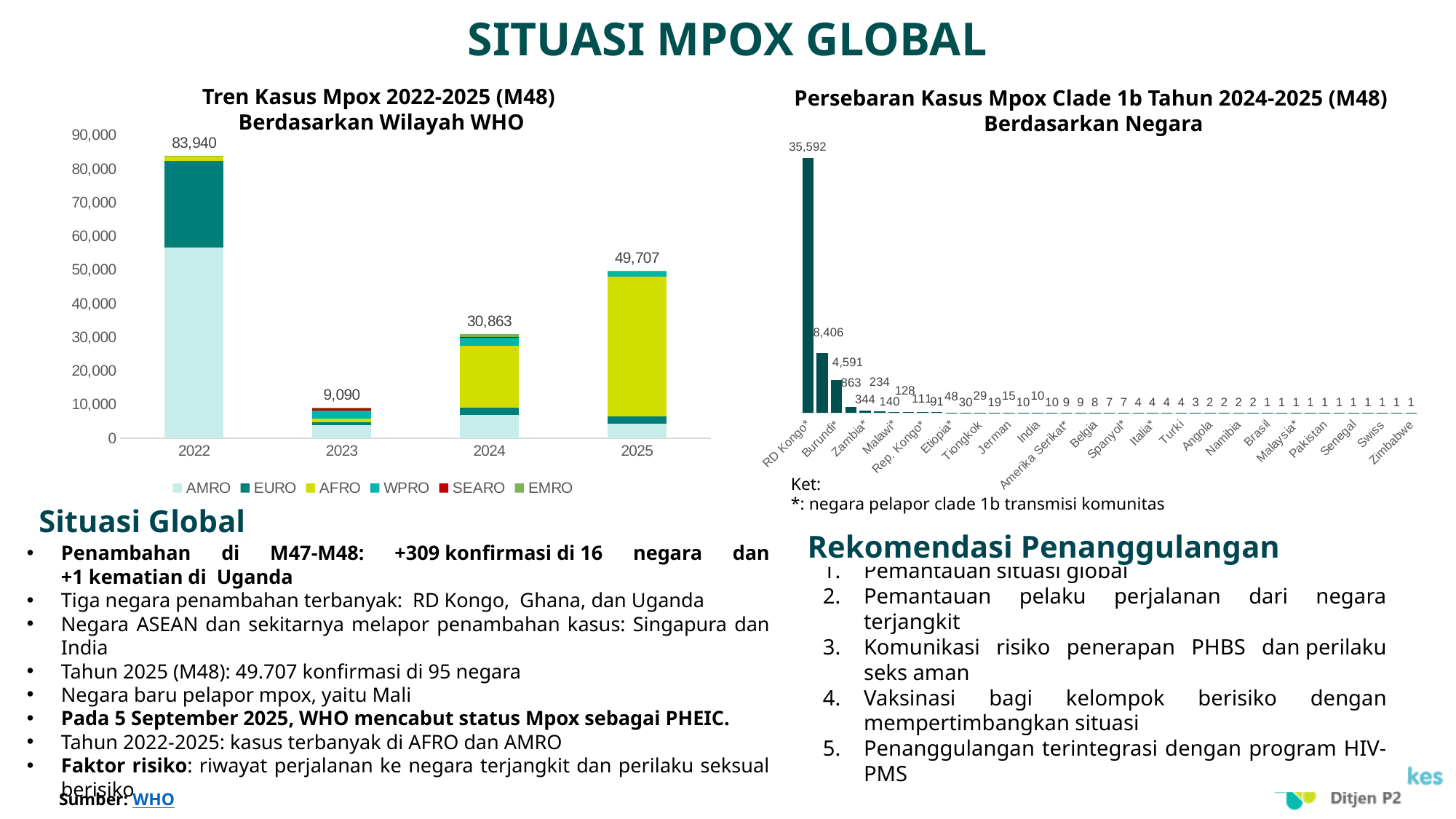
In the chart 'Tren Kasus Mpox 2022-2025 (M48) Berdasarkan Wilayah WHO', which is larger, the total for 2023 or the total for 2024? 2024 In the chart 'Tren Kasus Mpox 2022-2025 (M48) Berdasarkan Wilayah WHO', which year has the lowest total? 2023 In the chart 'Tren Kasus Mpox 2022-2025 (M48) Berdasarkan Wilayah WHO', what is the difference between the 2025 total and the 2024 total? 18,844 How many years are shown on the x axis of the chart 'Tren Kasus Mpox 2022-2025 (M48) Berdasarkan Wilayah WHO'? 4 In the chart 'Tren Kasus Mpox 2022-2025 (M48) Berdasarkan Wilayah WHO', what is the total number of cases for 2025? 49,707 In the chart 'Tren Kasus Mpox 2022-2025 (M48) Berdasarkan Wilayah WHO', which year has the highest total? 2022 Do the totals in the chart 'Tren Kasus Mpox 2022-2025 (M48) Berdasarkan Wilayah WHO' rise or fall from 2023 to 2025? rise In the chart 'Persebaran Kasus Mpox Clade 1b Tahun 2024-2025 (M48) Berdasarkan Negara', what is the value for RD Kongo*? 35,592 What kind of chart is 'Tren Kasus Mpox 2022-2025 (M48) Berdasarkan Wilayah WHO'? stacked bar chart In the chart 'Persebaran Kasus Mpox Clade 1b Tahun 2024-2025 (M48) Berdasarkan Negara', which country has the highest number of cases? RD Kongo* How many series does the legend of the chart 'Tren Kasus Mpox 2022-2025 (M48) Berdasarkan Wilayah WHO' list? 6 In the chart 'Tren Kasus Mpox 2022-2025 (M48) Berdasarkan Wilayah WHO', what is the total number of cases for 2022? 83,940